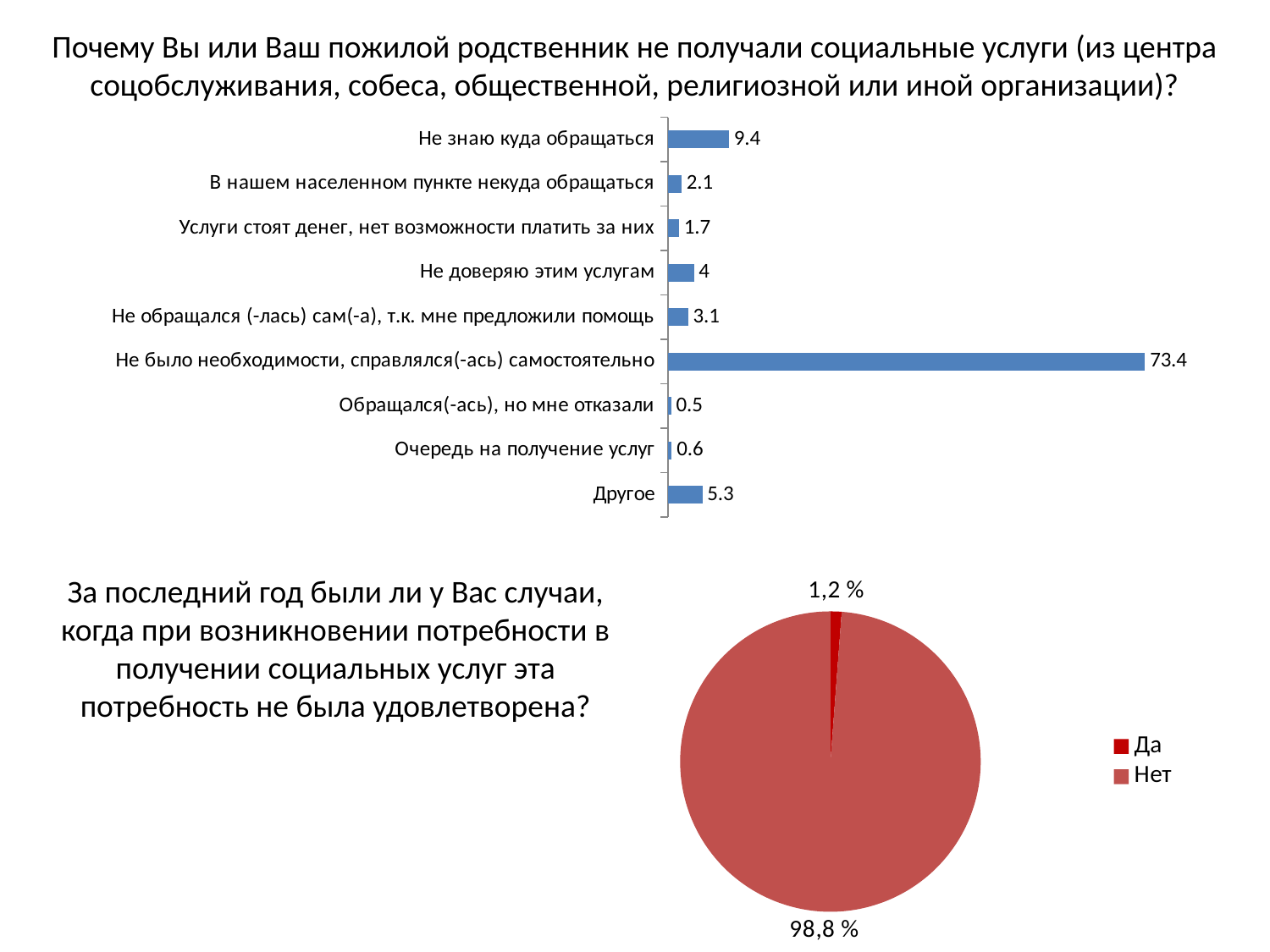
In the top bar chart, what is the value for "Не было необходимости, справлялся(-ась) самостоятельно"? 73.4 In the top bar chart, which category has the lowest value? Обращался(-ась), но мне отказали In the top bar chart, what is the value for "Не знаю куда обращаться"? 9.4 How many categories are shown in the top bar chart? 9 In the top bar chart, which is larger: the value for "В нашем населенном пункте некуда обращаться" or for "Услуги стоят денег, нет возможности платить за них"? В нашем населенном пункте некуда обращаться What type of chart is the top chart on the slide? Bar chart In the bottom pie chart, what share is labelled for "Да"? 1,2 % In the bottom pie chart, what share is labelled for "Нет"? 98,8 % In the top bar chart, what is the value for "Другое"? 5.3 How many entries does the legend of the bottom pie chart list? 2 In the top bar chart, which category has the highest value? Не было необходимости, справлялся(-ась) самостоятельно In the top bar chart, what is the difference between the values for "Не знаю куда обращаться" and "Не доверяю этим услугам"? 5.4